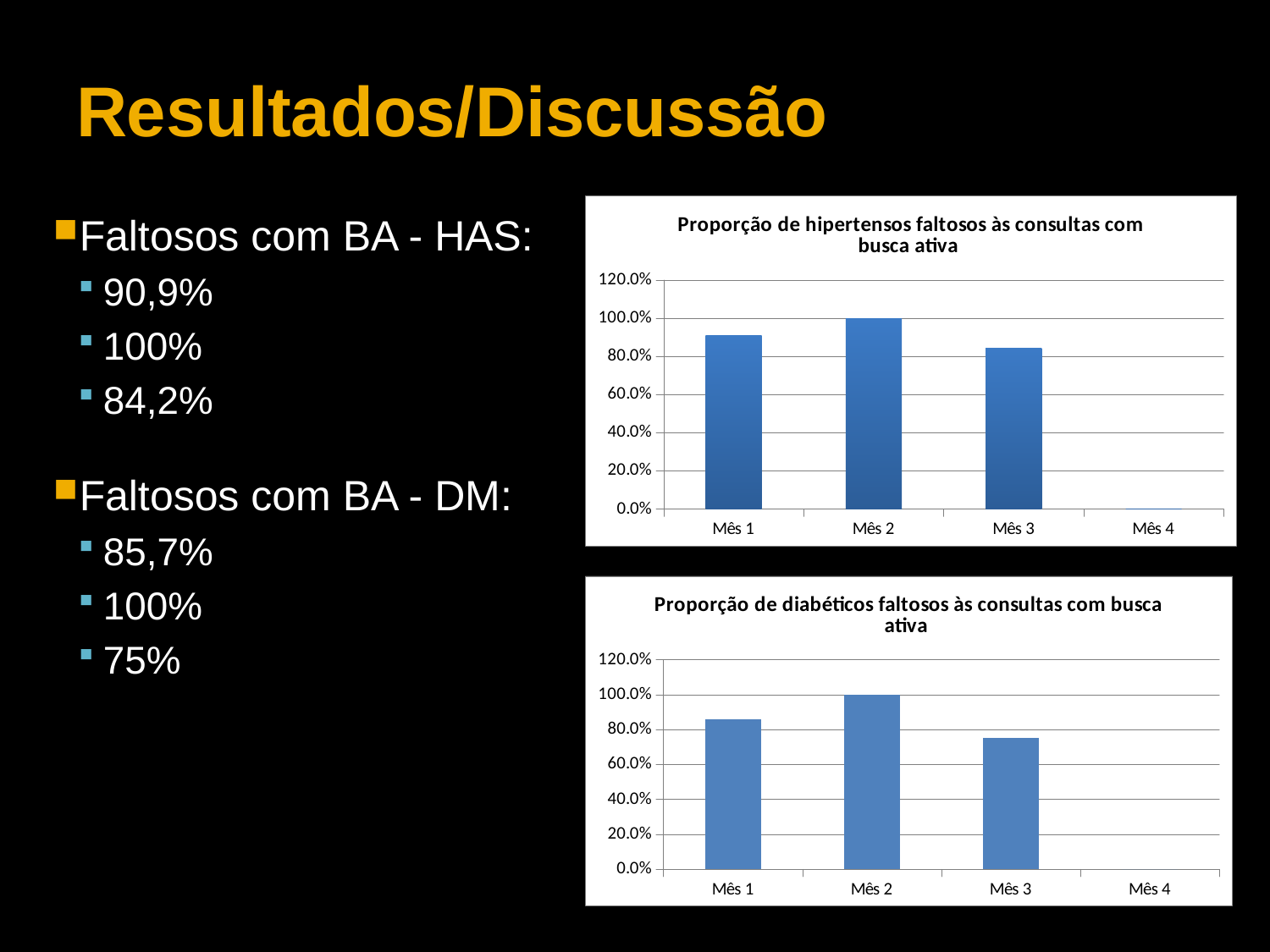
In the bottom chart (diabéticos), which month has the lowest value among the months with a bar? Mês 3 In the bottom chart (diabéticos), is the value for Mês 1 greater or less than 80.0%? greater What is the title of the bottom chart? Proporção de diabéticos faltosos às consultas com busca ativa In the bottom chart (diabéticos), what is the value for Mês 2? 100.0% In the bottom chart (diabéticos), is the value for Mês 3 greater or less than 80.0%? less In the top chart (hipertensos), is the value for Mês 3 greater or less than 80.0%? greater In the top chart (hipertensos), which month has the highest value? Mês 2 How many month categories are shown on the x axis of the bottom chart (diabéticos)? 4 In the top chart (hipertensos), which is larger, the value for Mês 1 or the value for Mês 3? Mês 1 What kind of chart is the top chart, 'Proporção de hipertensos faltosos às consultas com busca ativa'? bar chart In the top chart (hipertensos), what is the value for Mês 2? 100.0% In the top chart (hipertensos), do the values rise or fall from Mês 2 to Mês 3? fall